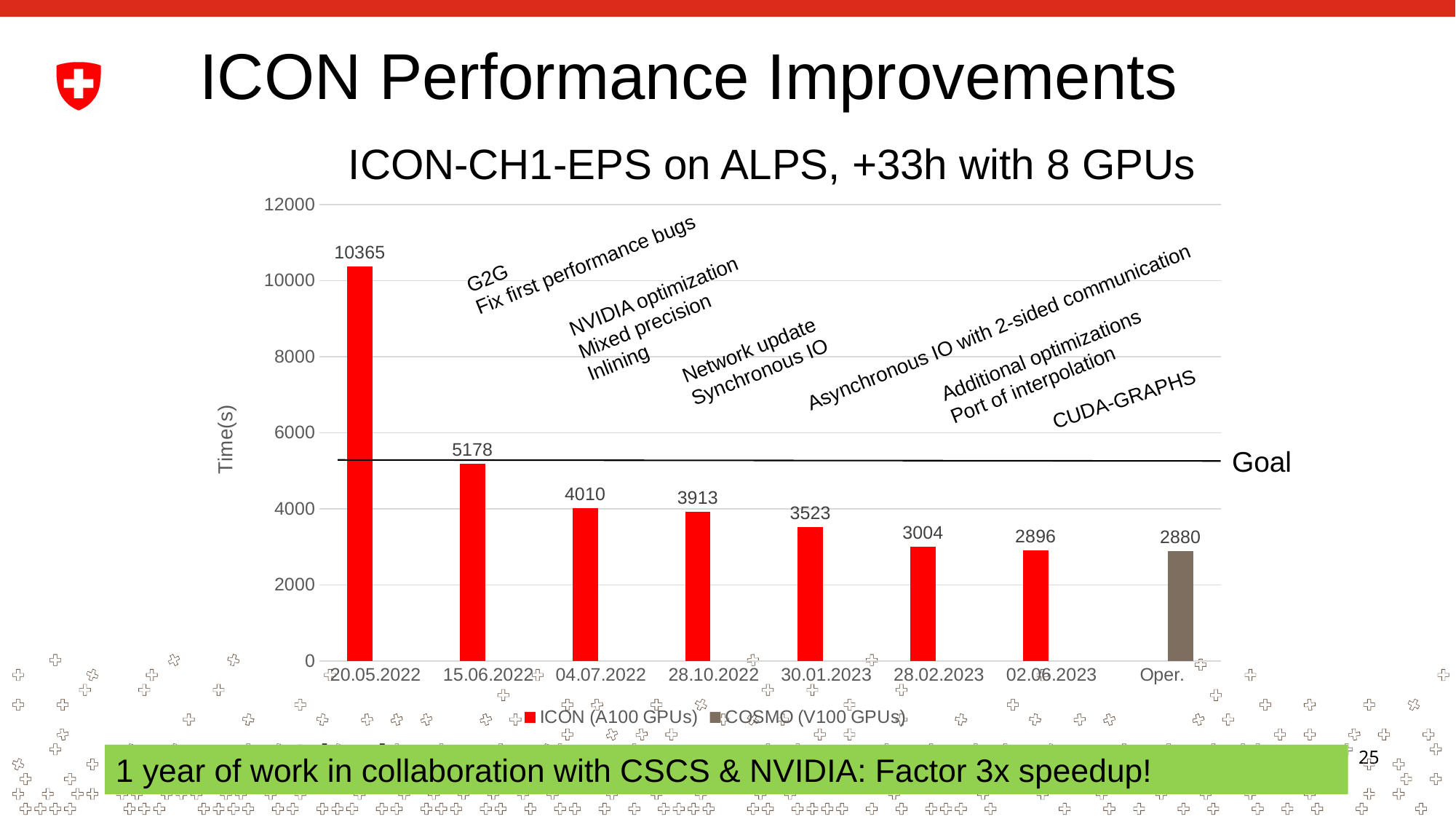
What is the value for 02.06.2023? 2896 What kind of chart is shown? bar chart What is the value for the Oper. bar? 2880 Which is larger, the value for 30.01.2023 or the value for 28.02.2023? 30.01.2023 What is the difference between the values for 20.05.2022 and 15.06.2022? 5187 Which category has the lowest value? Oper. What is the value for 20.05.2022? 10365 How many bars are plotted in the chart? 8 Do the values rise or fall from left to right along the x axis? fall How many series does the legend list? 2 What is the difference between the values for 04.07.2022 and 28.10.2022? 97 Which category has the highest value? 20.05.2022